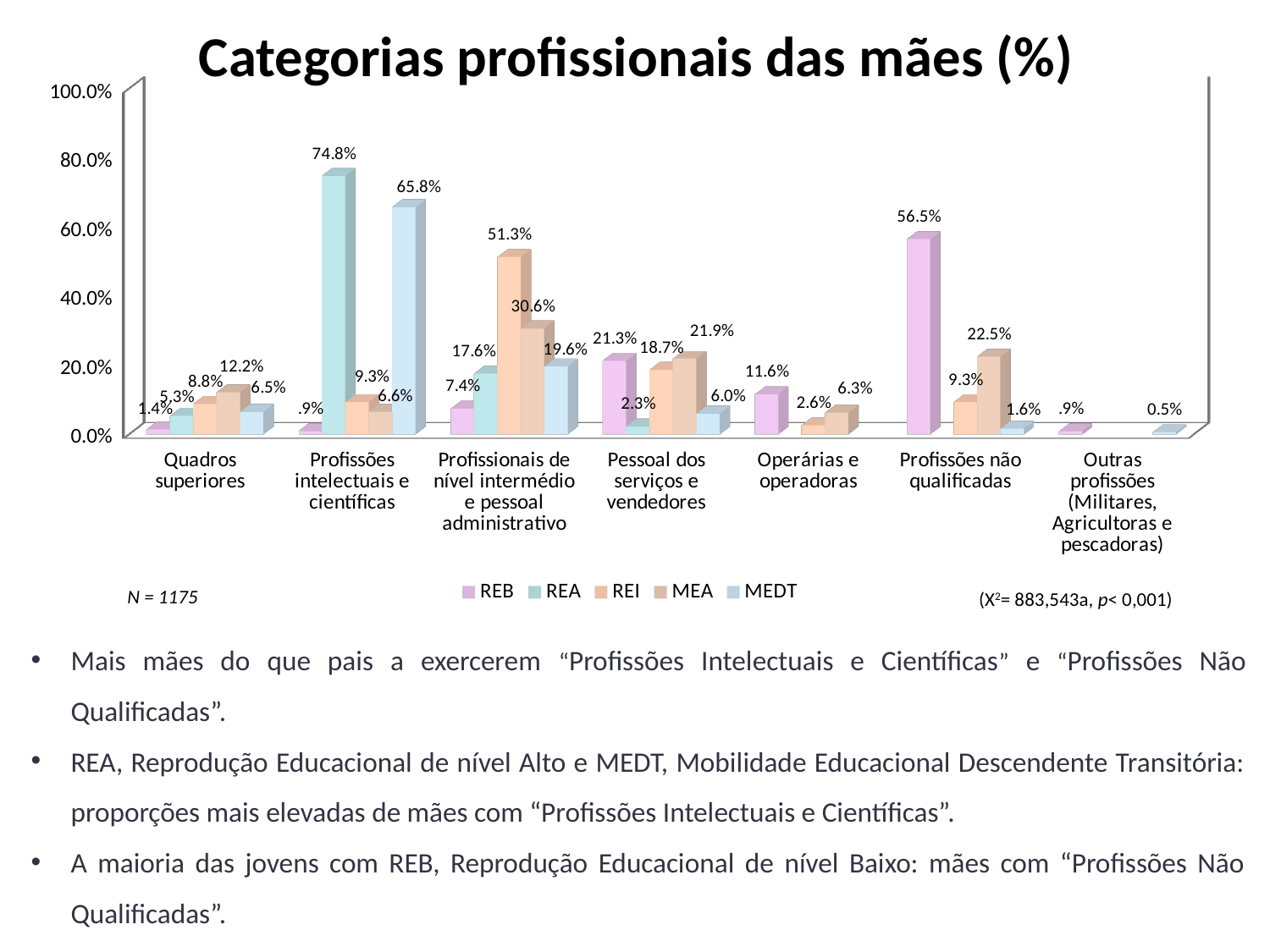
What is the REI value for "Profissionais de nível intermédio e pessoal administrativo"? 51.3% What is the REB value for "Profissões não qualificadas"? 56.5% What is the MEA value for "Profissionais de nível intermédio e pessoal administrativo"? 30.6% How many professional categories are shown on the x axis? 7 In which category does the REB series reach its highest value? Profissões não qualificadas What is the difference between the REA and MEDT values for "Profissões intelectuais e científicas"? 9.0 percentage points How many series does the legend list? 5 Which is larger: the REB value for "Profissões não qualificadas" or the REI value for "Profissionais de nível intermédio e pessoal administrativo"? REB for Profissões não qualificadas Which series has the highest value in the "Quadros superiores" category? MEA What kind of chart is shown on the slide? bar chart What is the REA value for "Profissões intelectuais e científicas"? 74.8% What is the MEDT value for "Profissões intelectuais e científicas"? 65.8%